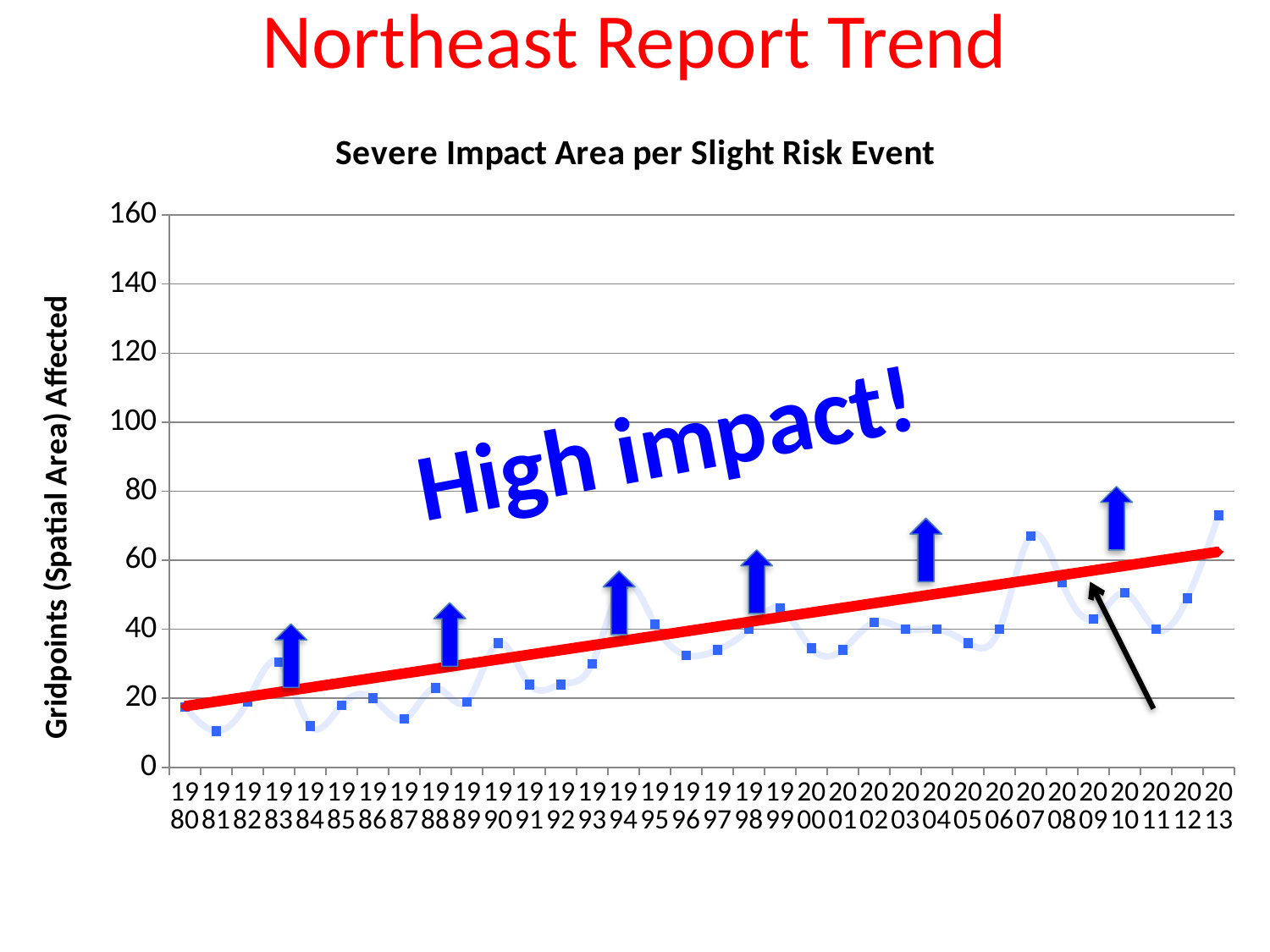
Is the value for 2013 greater or less than 60? greater Which year has the highest plotted value? 2013 What is the title of the chart? Severe Impact Area per Slight Risk Event How many years are plotted along the x axis of the chart? 34 Do the plotted values generally rise or fall from 1980 to 2013? rise Is the value for 2007 greater or less than 60? greater What kind of chart is shown on the slide? line chart Is the value for 1999 greater or less than 40? greater Which is larger, the value for 1980 or the value for 2013? 2013 What is the label on the vertical axis of the chart? Gridpoints (Spatial Area) Affected